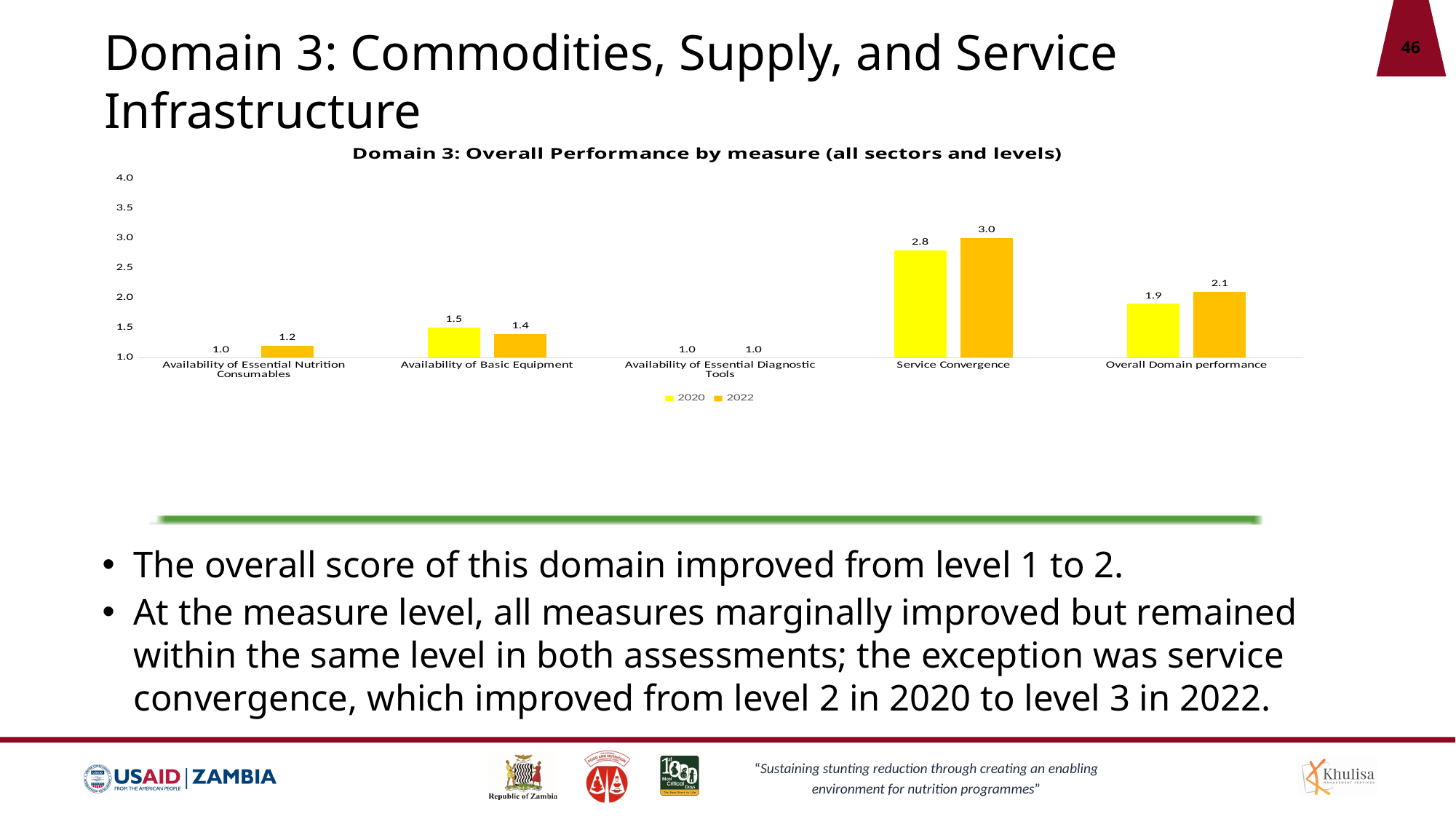
What is the difference between the 2022 and 2020 values for Service Convergence? 0.2 Which category has the highest 2022 value? Service Convergence What kind of chart is shown on the slide? Bar chart What is the 2020 value for Availability of Basic Equipment? 1.5 Is the 2020 value for Service Convergence greater or less than 2.5? greater What is the title of the chart? Domain 3: Overall Performance by measure (all sectors and levels) Which category has the lowest 2022 value? Availability of Essential Diagnostic Tools What is the 2022 value for Overall Domain performance? 2.1 What is the 2022 value for Service Convergence? 3.0 How many series does the legend list? 2 Which is larger for Availability of Basic Equipment, the 2020 value or the 2022 value? 2020 How many categories are shown on the x axis? 5